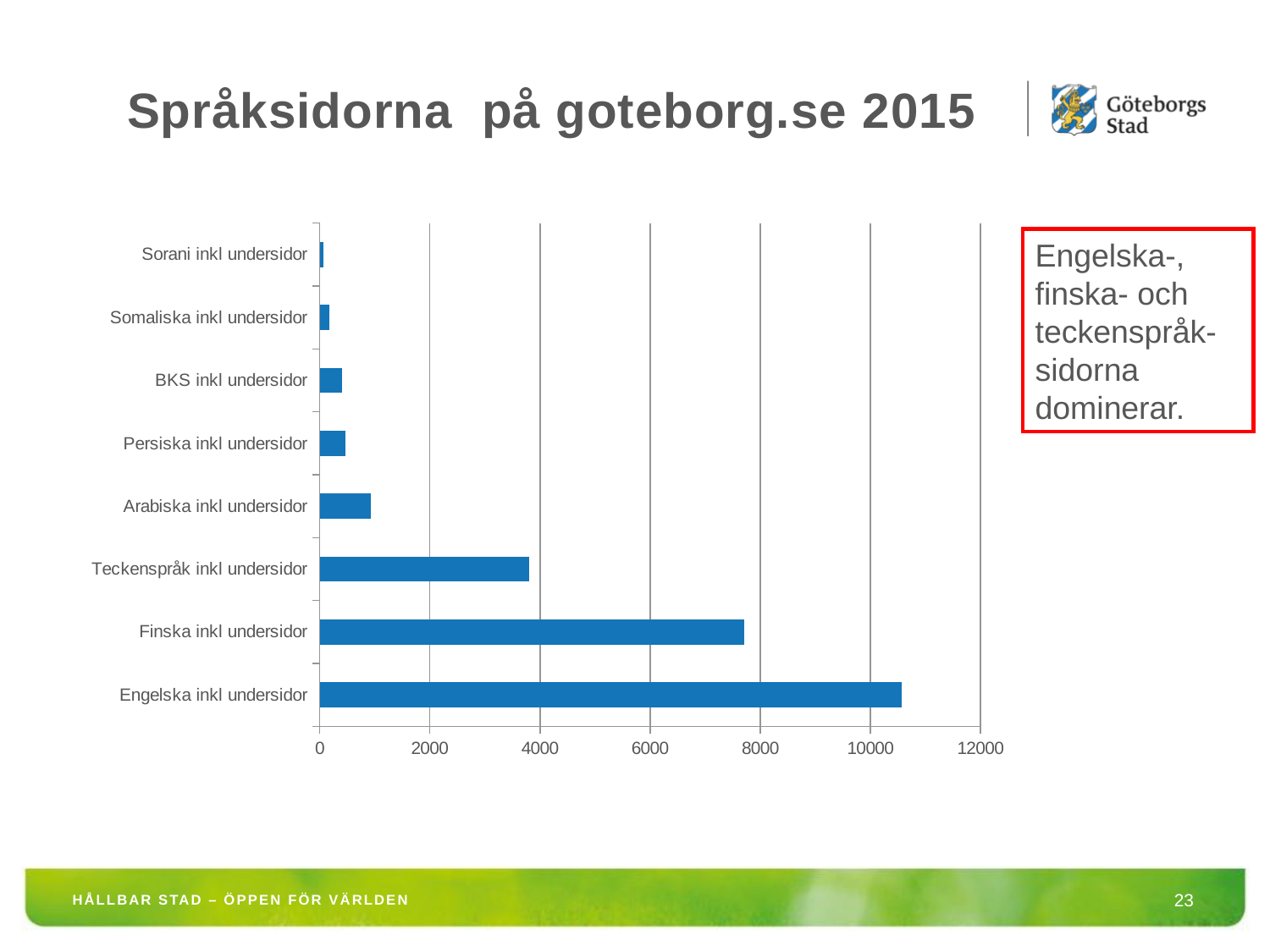
Which is larger, the value for Arabiska inkl undersidor or Somaliska inkl undersidor? Arabiska inkl undersidor What kind of chart is shown on the slide? Bar chart What is the highest value shown on the x axis of the chart? 12000 Which category has the shortest bar in the chart? Sorani inkl undersidor What is the title of the slide containing the chart? Språksidorna på goteborg.se 2015 Is the value for Engelska inkl undersidor greater or less than 10000? greater Which category has the longest bar in the chart? Engelska inkl undersidor Is the value for Teckenspråk inkl undersidor greater or less than 4000? less Which is larger, the value for Finska inkl undersidor or Teckenspråk inkl undersidor? Finska inkl undersidor Is the value for Finska inkl undersidor greater or less than 8000? less How many categories are shown in the chart? 8